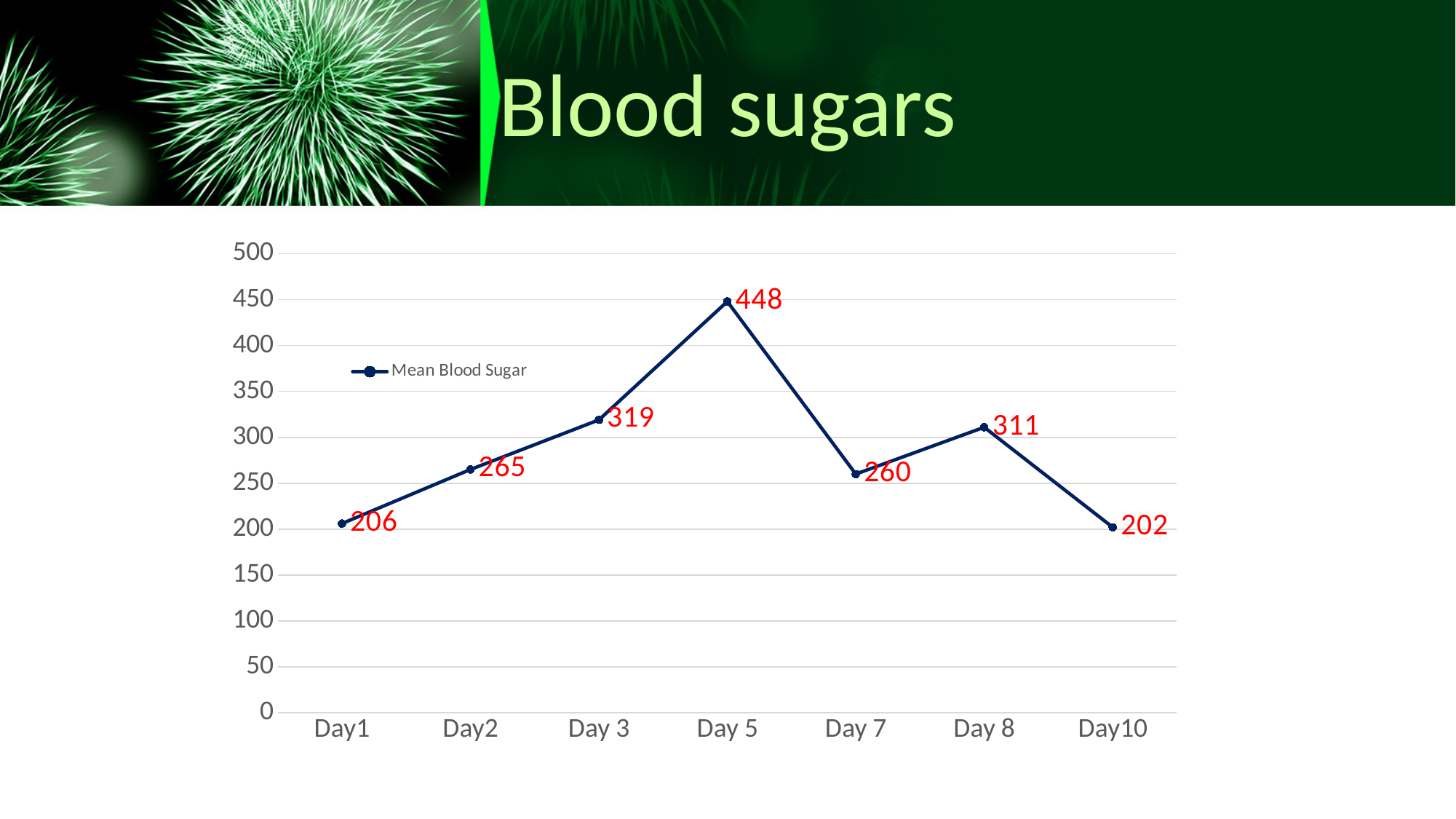
Which is larger, the Mean Blood Sugar on Day 3 or on Day 8? Day 3 Which day has the lowest Mean Blood Sugar? Day10 What is the Mean Blood Sugar value for Day 5? 448 What kind of chart is shown on the slide? line chart Does the Mean Blood Sugar rise or fall from Day1 to Day 5? rise How many days are plotted on the x axis? 7 Which day has the highest Mean Blood Sugar? Day 5 What is the difference between the Mean Blood Sugar on Day 5 and on Day 7? 188 What is the Mean Blood Sugar value for Day 8? 311 What is the Mean Blood Sugar value for Day1? 206 Is the Mean Blood Sugar value for Day2 greater or less than 250? greater How many series does the legend list? 1